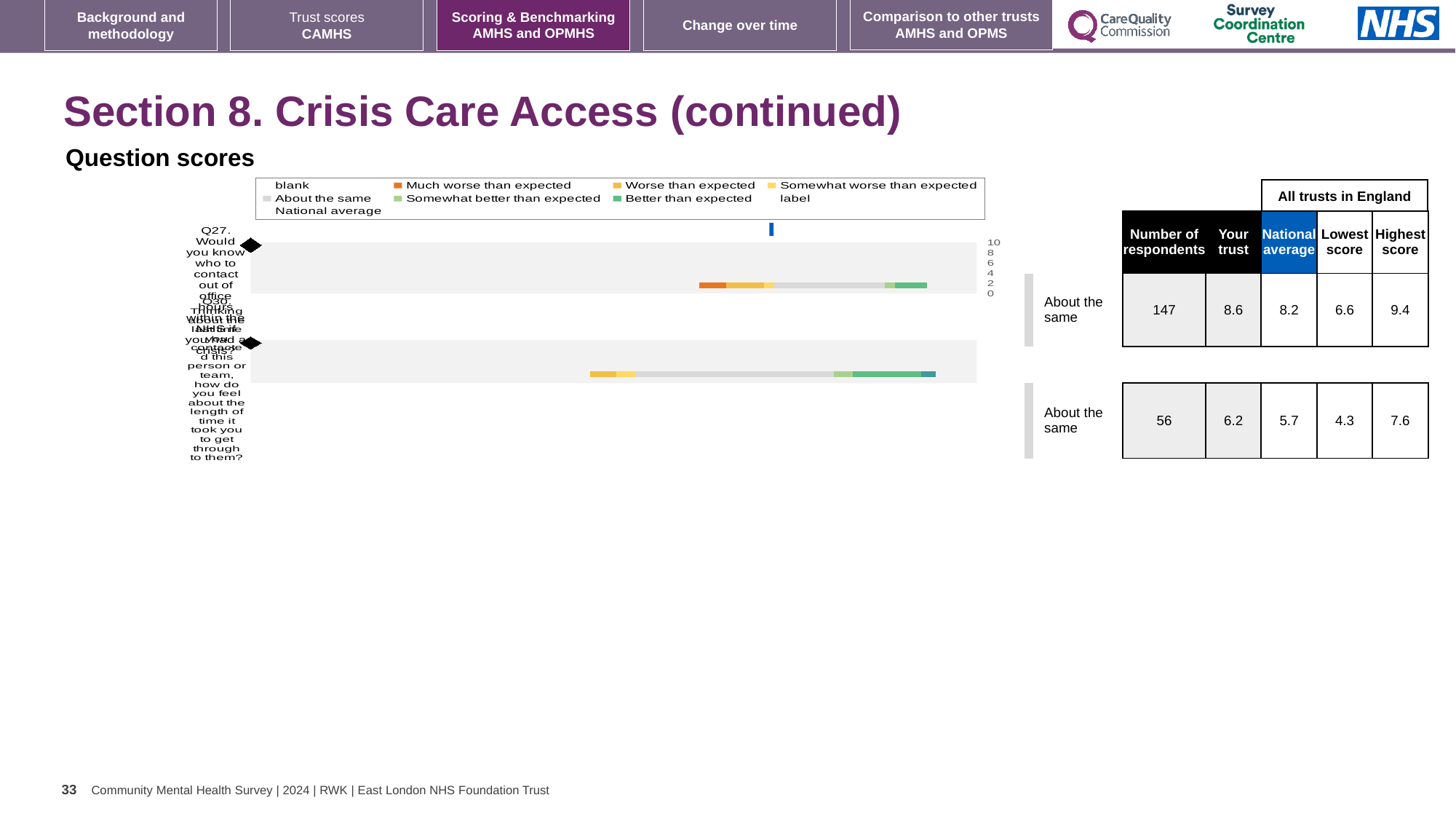
In the table beside the chart, how many respondents are listed for Q27? 147 For Q27, which is larger: the 'Your trust' score or the national average? Your trust In the table beside the chart, what is the 'Your trust' score for Q30? 6.2 In the table beside the chart, what is the national average for Q27? 8.2 What is the highest tick value shown on the chart's axis? 10 How many questions (categories) are plotted in the Question scores chart? 2 What kind of chart is shown under 'Question scores'? bar chart Which question has the larger number of respondents, Q27 or Q30? Q27 Which colour does the legend use for 'Much worse than expected'? orange For Q27, what is the difference between the 'Your trust' score and the national average? 0.4 For Q30, what is the difference between the highest score and the lowest score? 3.3 In the table beside the chart, what is the highest score for Q30? 7.6